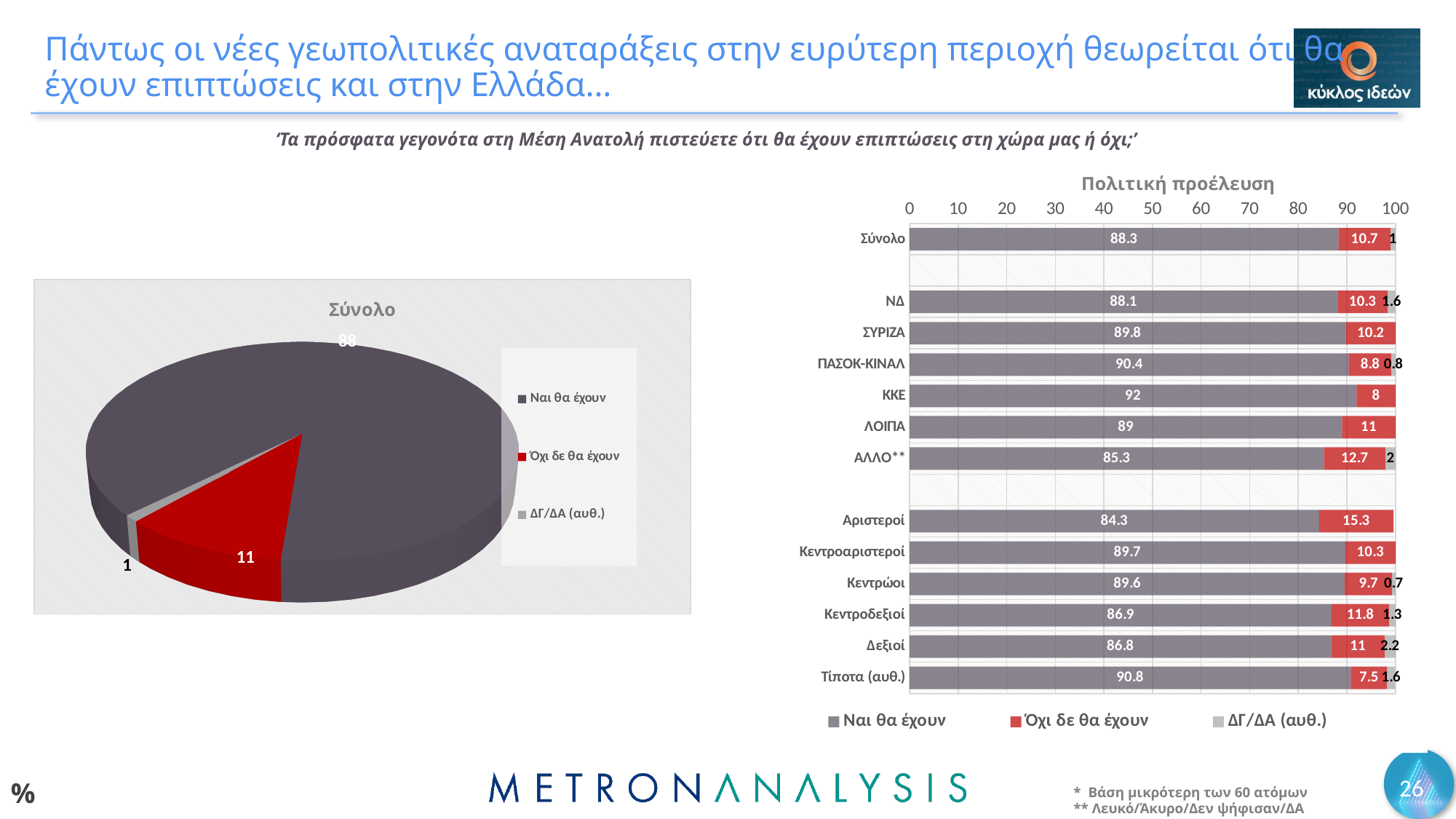
In the bar chart titled Πολιτική προέλευση, which category has the highest value for Ναι θα έχουν? ΚΚΕ What kind of chart is the chart on the left of the slide? Pie chart In the pie chart titled Σύνολο, what is the value for Όχι δε θα έχουν? 11 In the bar chart titled Πολιτική προέλευση, which category has the lowest value for Όχι δε θα έχουν? Τίποτα (αυθ.) How many series does the legend of the bar chart titled Πολιτική προέλευση list? 3 In the bar chart titled Πολιτική προέλευση, what is the value of Ναι θα έχουν for ΚΚΕ? 92 What kind of chart is the chart titled Πολιτική προέλευση? Bar chart How many categories are shown in the bar chart titled Πολιτική προέλευση? 13 In the pie chart titled Σύνολο, what is the value for Ναι θα έχουν? 88 In the bar chart titled Πολιτική προέλευση, which is larger: the Όχι δε θα έχουν value for ΑΛΛΟ** or for Κεντροδεξιοί? ΑΛΛΟ** In the bar chart titled Πολιτική προέλευση, what is the value of Όχι δε θα έχουν for Αριστεροί? 15.3 In the bar chart titled Πολιτική προέλευση, what is the difference between the Ναι θα έχουν values for ΚΚΕ and Αριστεροί? 7.7